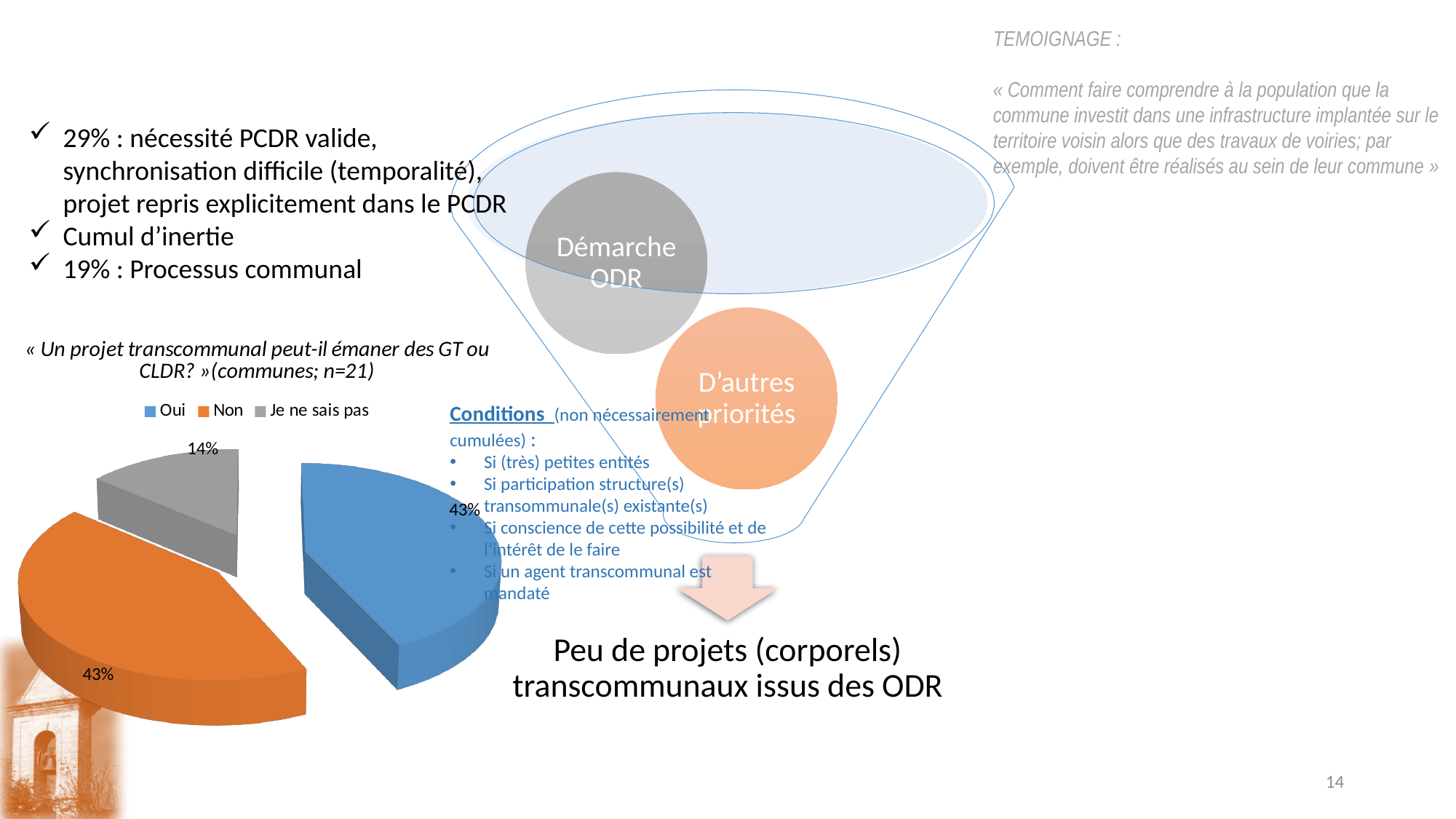
What colour is the 'Non' slice in the pie chart? orange What is the difference in percentage points between the 'Oui' and 'Non' slices? 0 What percentage of the pie chart is the 'Non' slice? 43% How many slices does the pie chart have? 3 What percentage of the pie chart is the 'Oui' slice? 43% What percentage of the pie chart is the 'Je ne sais pas' slice? 14% Which category has the smallest slice in the pie chart? Je ne sais pas What kind of chart is shown on the slide? pie chart What is the difference in percentage points between the 'Oui' slice and the 'Je ne sais pas' slice? 29 What sample size (n) is given in the pie chart title? n=21 Which slice is larger in the pie chart, 'Non' or 'Je ne sais pas'? Non How many entries does the pie chart legend list? 3